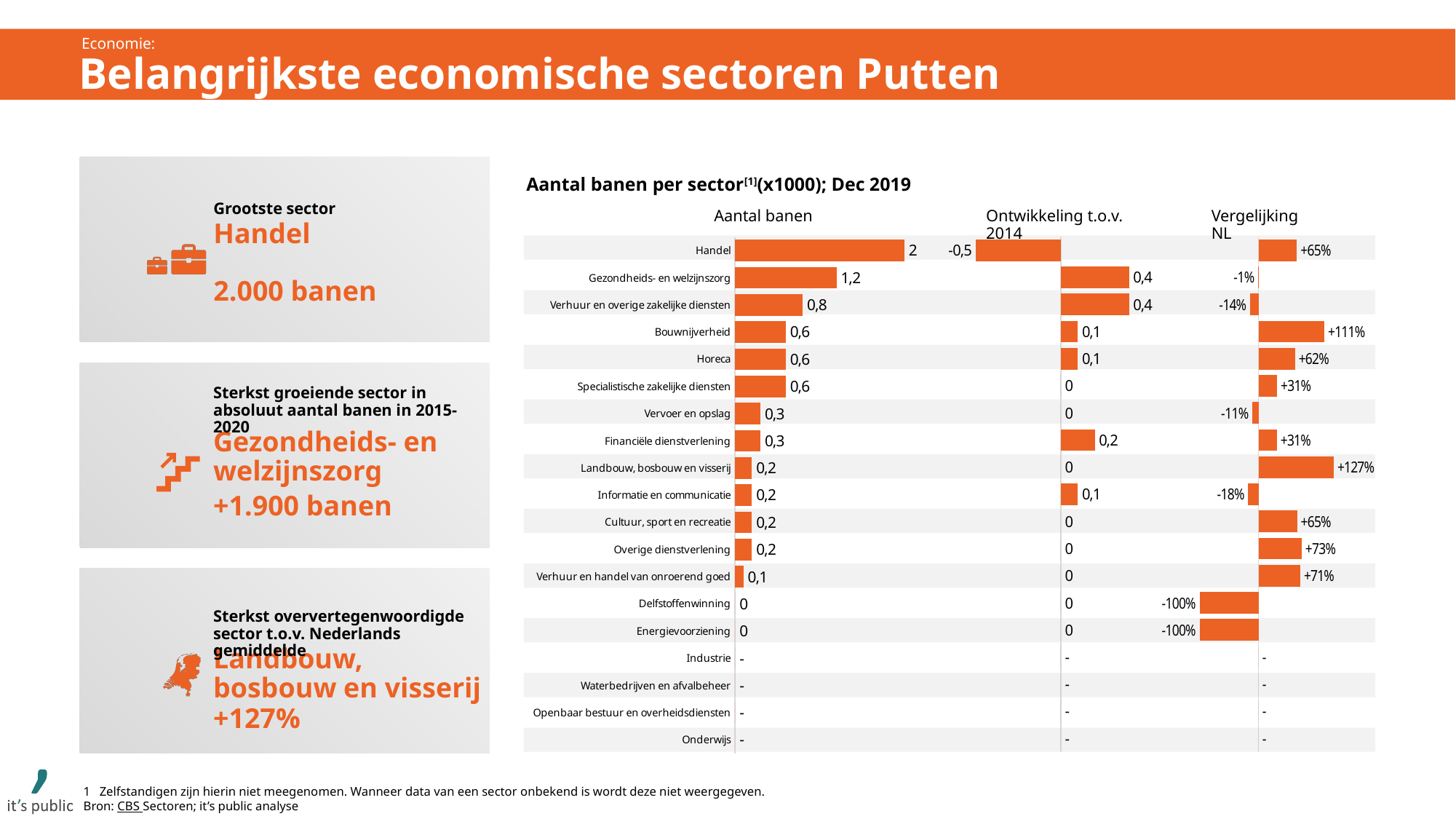
In the 'Vergelijking NL' column, which is larger: Horeca or Overige dienstverlening? Overige dienstverlening Which sector has the lowest value in the 'Ontwikkeling t.o.v. 2014' column? Handel Which sector has the highest value in the 'Vergelijking NL' column? Landbouw, bosbouw en visserij What is the difference between the 'Aantal banen' values for Handel and Gezondheids- en welzijnszorg? 0,8 Which sector has the highest value in the 'Aantal banen' column? Handel In the 'Ontwikkeling t.o.v. 2014' column, what is the value for Handel? -0,5 In the 'Aantal banen' column, what is the value for Handel? 2 In the 'Vergelijking NL' column, what is the value for Bouwnijverheid? +111% How many sectors are listed in the chart? 19 In the 'Vergelijking NL' column, what is the value for Landbouw, bosbouw en visserij? +127% What kind of chart is used to show the values on this slide? Bar chart In the 'Aantal banen' column, what is the value for Gezondheids- en welzijnszorg? 1,2